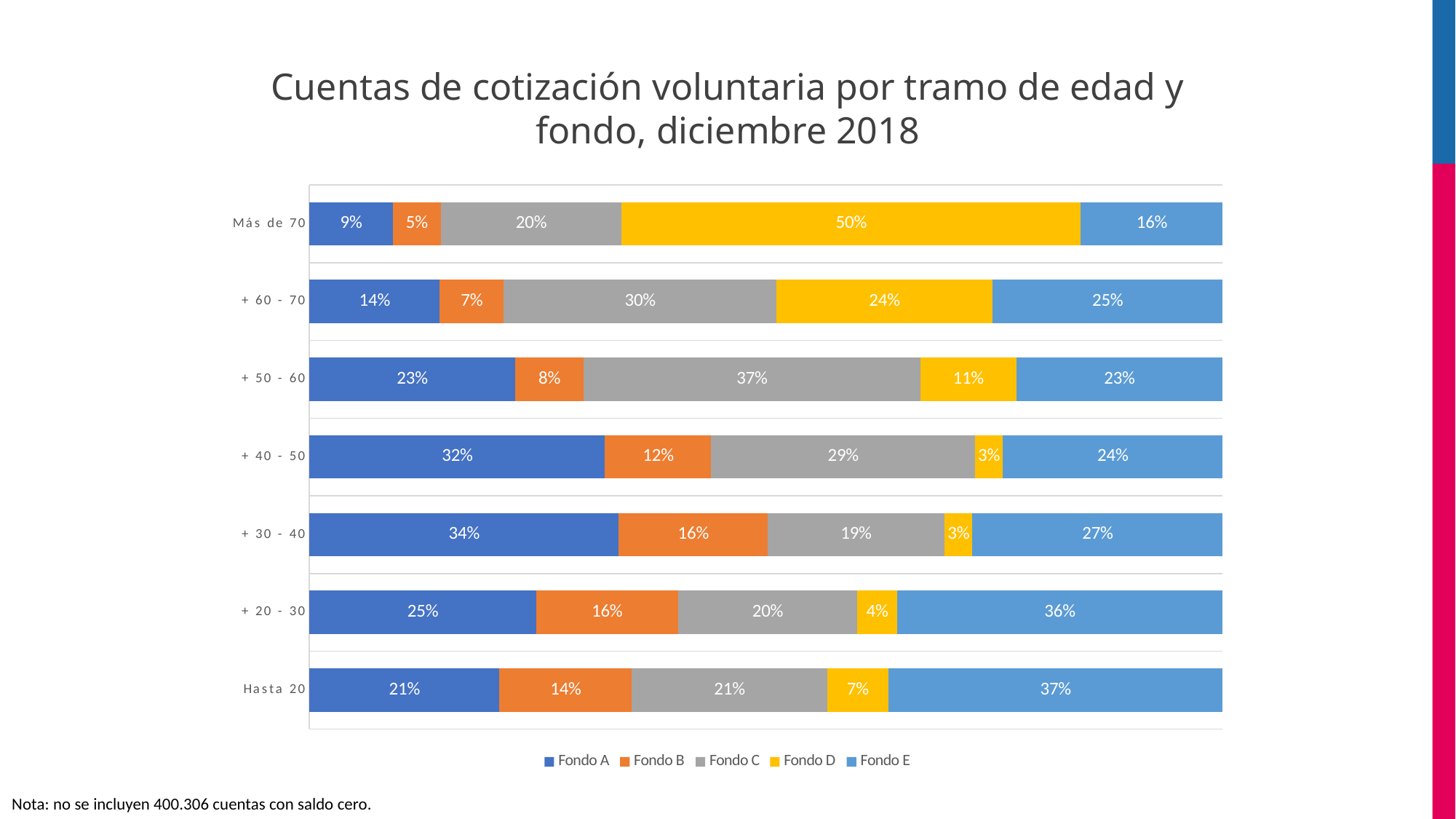
What is the value for Fondo E in the 'Hasta 20' age group? 37% How many series does the legend list? 5 What is the value for Fondo C in the '+ 50 - 60' age group? 37% Which age group has the highest value for Fondo D? Más de 70 What is the difference between Fondo E in '+ 20 - 30' and Fondo E in 'Más de 70'? 20% Which age group has the lowest value for Fondo A? Más de 70 What is the title of the chart? Cuentas de cotización voluntaria por tramo de edad y fondo, diciembre 2018 What is the value for Fondo D in the 'Más de 70' age group? 50% Which is larger: Fondo B in '+ 40 - 50' or Fondo B in '+ 60 - 70'? Fondo B in + 40 - 50 What is the value for Fondo A in the '+ 30 - 40' age group? 34% What kind of chart is shown on the slide? Stacked bar chart How many age groups are shown on the chart? 7